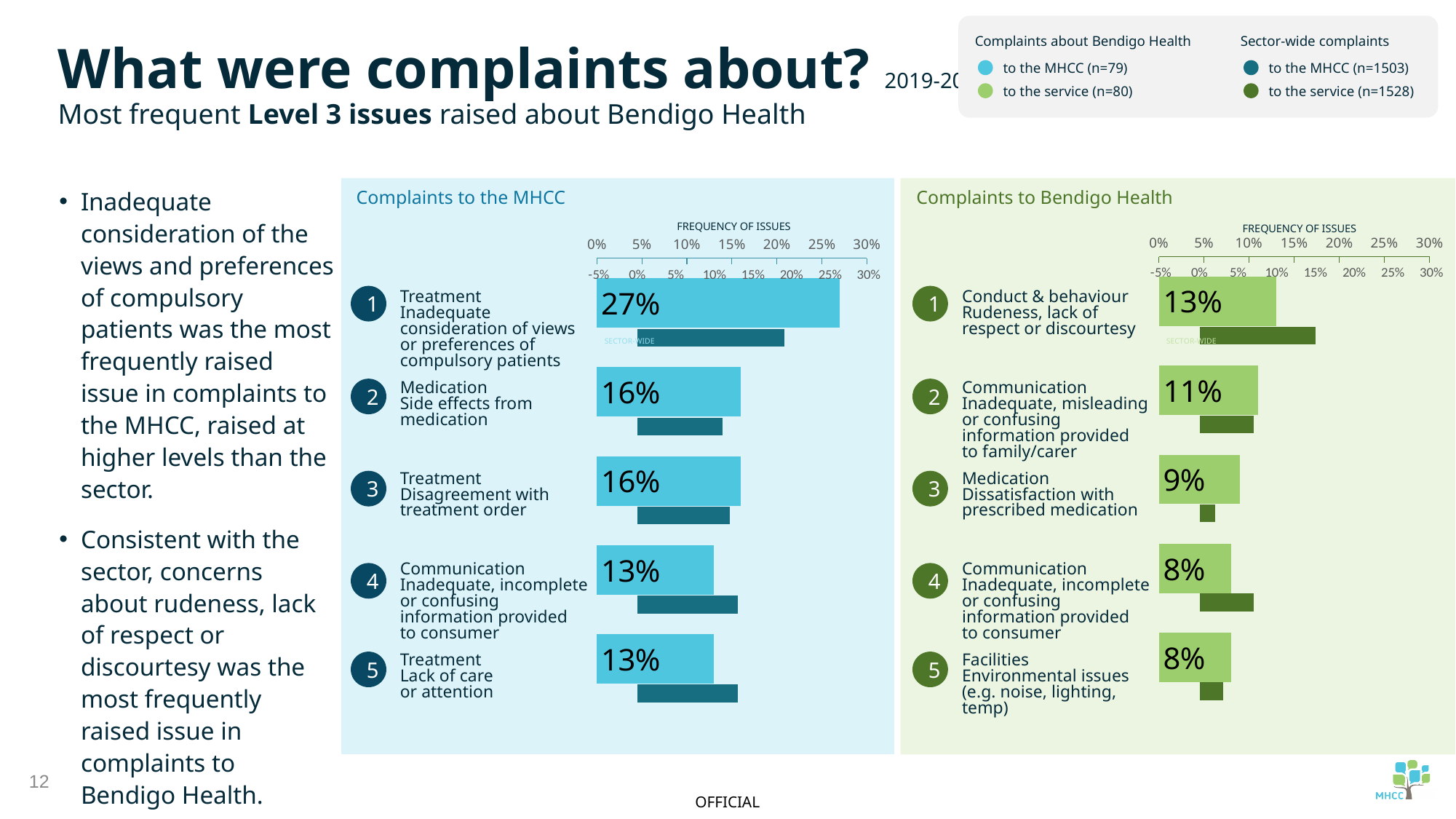
In the 'Complaints to the MHCC' chart, what is the difference in percentage points between the Treatment – inadequate consideration issue (27%) and Medication – side effects (16%)? 11 percentage points In the 'Complaints to Bendigo Health' chart, which is larger: the frequency for Communication – information provided to family/carer or for Medication – dissatisfaction with prescribed medication? Communication – information provided to family/carer In the 'Complaints to Bendigo Health' chart, what is the difference in percentage points between Conduct & behaviour (13%) and Facilities – environmental issues (8%)? 5 percentage points In the 'Complaints to the MHCC' chart, what is the frequency for the top issue, Treatment – inadequate consideration of views or preferences of compulsory patients? 27% How many entries does the legend at the top right of the slide list? 4 How many issues are listed in the 'Complaints to the MHCC' chart? 5 In the 'Complaints to the MHCC' chart, what is the frequency for Medication – side effects from medication? 16% In the 'Complaints to Bendigo Health' chart, what is the frequency for Conduct & behaviour – rudeness, lack of respect or discourtesy? 13% In the 'Complaints to Bendigo Health' chart, what is the frequency for Medication – dissatisfaction with prescribed medication? 9% In the 'Complaints to Bendigo Health' chart, which issue has the highest frequency? Conduct & behaviour – rudeness, lack of respect or discourtesy What type of chart is used in the 'Complaints to Bendigo Health' panel? Bar chart In the 'Complaints to the MHCC' chart, which issue has the highest frequency? Treatment – inadequate consideration of views or preferences of compulsory patients